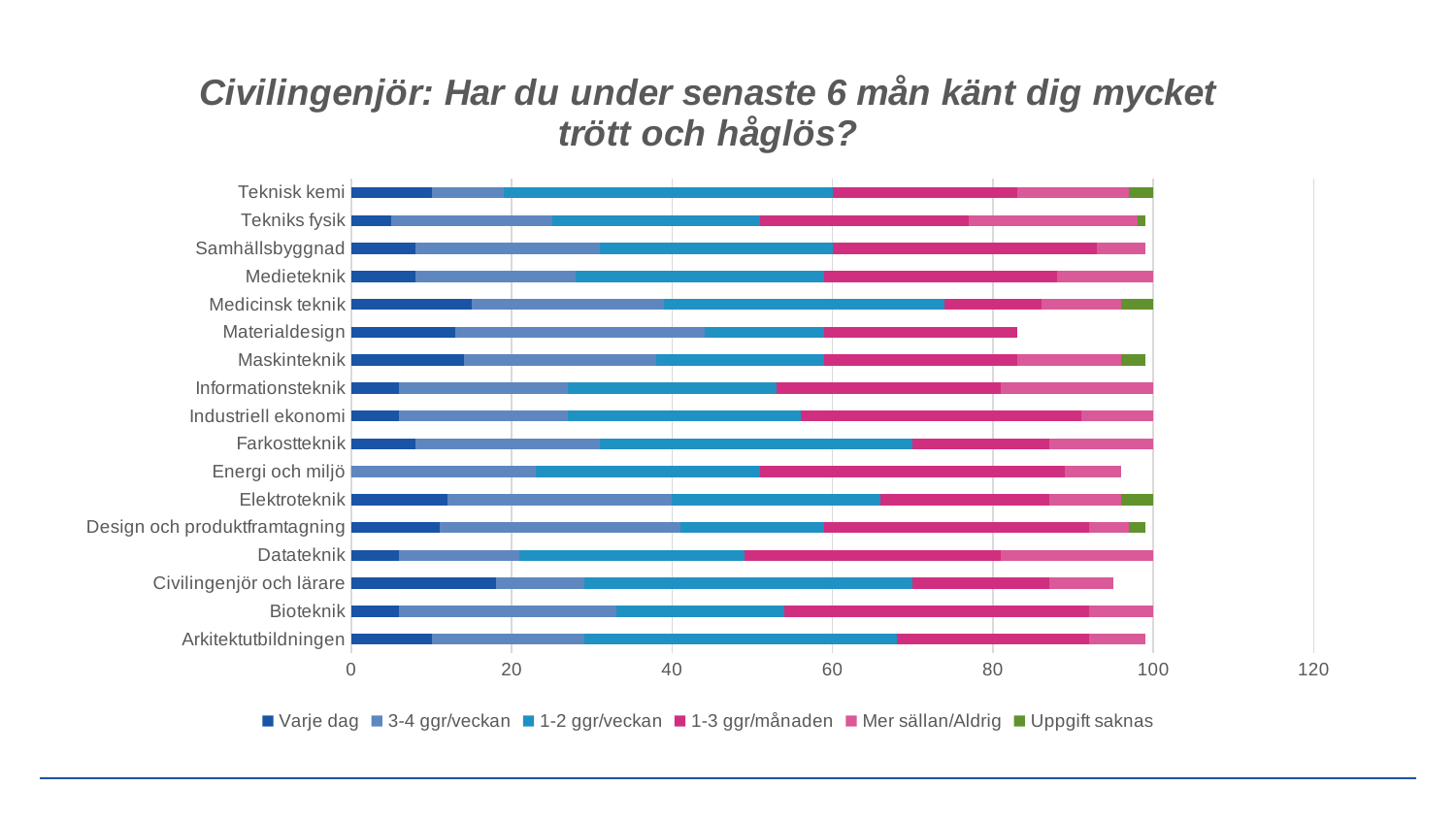
Which category has the shortest total bar? Materialdesign What kind of chart is shown on the slide? Stacked bar chart How many categories (programmes) are listed on the vertical axis of the chart? 17 Which legend entry is shown in green? Uppgift saknas Is the total bar length for Materialdesign greater or less than 100? less Which category has no 'Varje dag' segment at all? Energi och miljö Is the 'Varje dag' value for Tekniks fysik greater or less than 20? less Which has the larger 'Varje dag' value, Civilingenjör och lärare or Datateknik? Civilingenjör och lärare What is the title of the chart? Civilingenjör: Har du under senaste 6 mån känt dig mycket trött och håglös? How many series does the legend list? 6 Is the total bar length for Civilingenjör och lärare greater or less than 100? less Which category has the largest 'Varje dag' segment? Civilingenjör och lärare